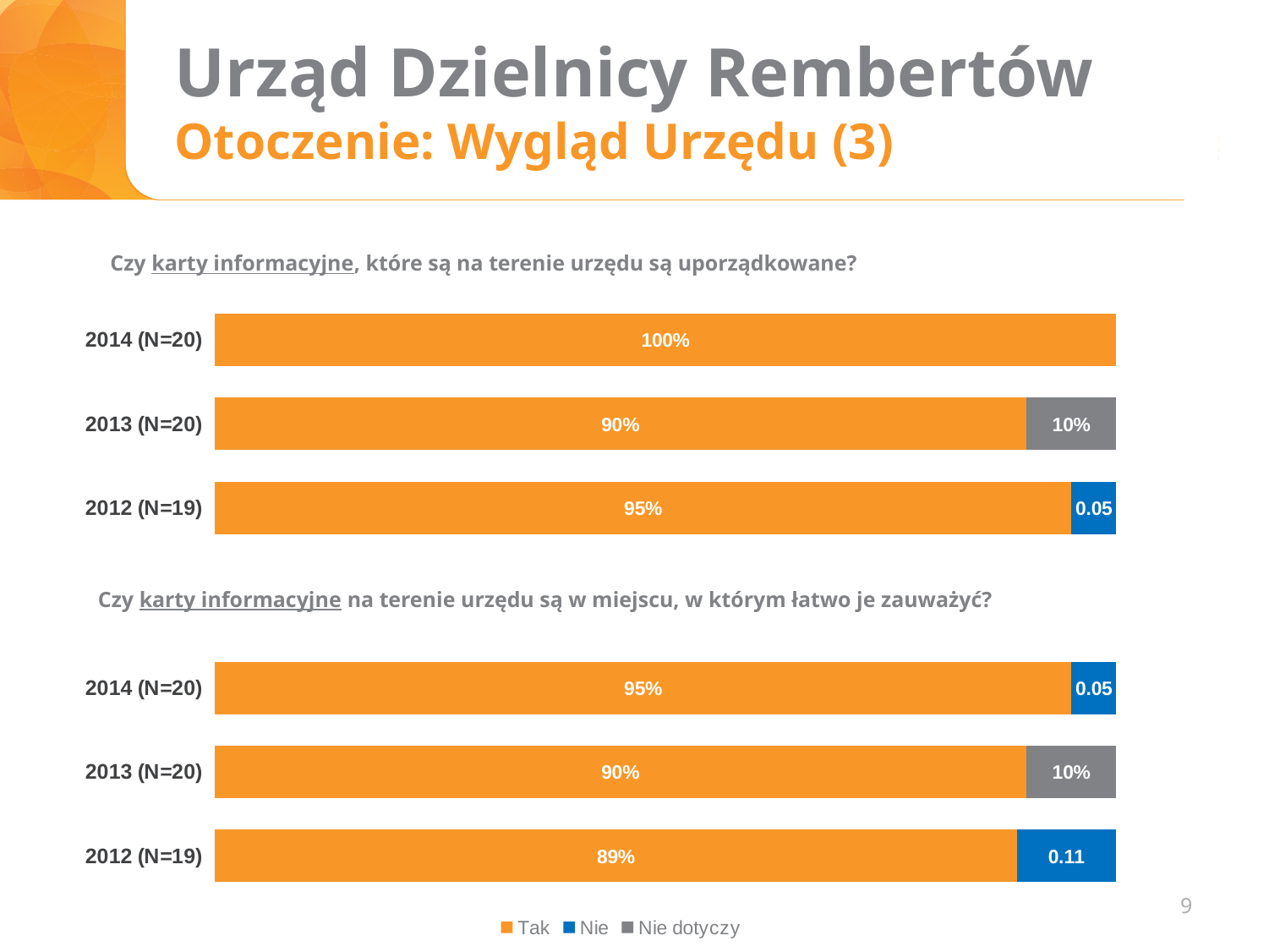
In the top chart, what is the value for "Tak" for 2014 (N=20)? 100% In the top chart, what is the value for "Nie" for 2012 (N=19)? 0.05 In the top chart, which year has the highest "Tak" value? 2014 (N=20) In the bottom chart, what is the difference between the "Tak" values for 2014 (N=20) and 2012 (N=19)? 6% What kind of chart is the bottom chart? stacked bar chart In the bottom chart, what is the value for "Nie" for 2012 (N=19)? 0.11 In the bottom chart, what is the value for "Tak" for 2012 (N=19)? 89% How many series does the legend list? 3 In the bottom chart, what is the value for "Nie dotyczy" for 2013 (N=20)? 10% In the top chart, is the "Tak" value for 2013 (N=20) larger or smaller than for 2012 (N=19)? smaller In the top chart, what is the value for "Tak" for 2013 (N=20)? 90% In the bottom chart, which year has the lowest "Tak" value? 2012 (N=19)